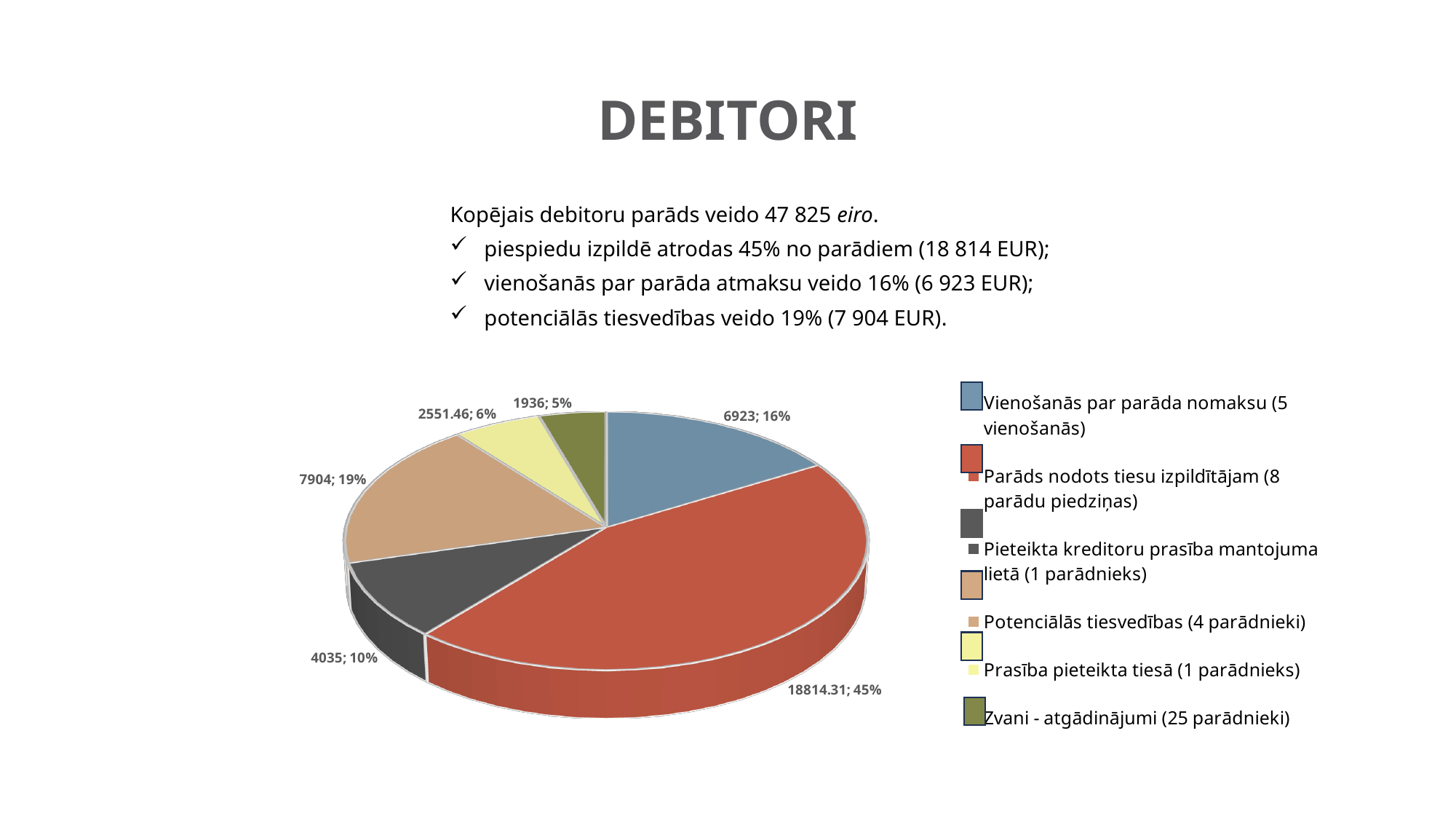
What value is shown for the slice 'Zvani - atgādinājumi (25 parādnieki)'? 1936 What is the difference between the values for 'Potenciālās tiesvedības (4 parādnieki)' and 'Pieteikta kreditoru prasība mantojuma lietā (1 parādnieks)'? 3869 What value is shown for the slice 'Potenciālās tiesvedības (4 parādnieki)'? 7904 What value is shown for the slice 'Vienošanās par parāda nomaksu (5 vienošanās)'? 6923 Which slice of the pie chart is the largest? Parāds nodots tiesu izpildītājam (8 parādu piedziņas) What type of chart is shown on the slide? pie chart What value is shown for the slice 'Parāds nodots tiesu izpildītājam (8 parādu piedziņas)'? 18814.31 Which is larger: the value for 'Potenciālās tiesvedības (4 parādnieki)' or for 'Vienošanās par parāda nomaksu (5 vienošanās)'? Potenciālās tiesvedības (4 parādnieki) Which slice of the pie chart is the smallest? Zvani - atgādinājumi (25 parādnieki) What percentage share does the slice 'Pieteikta kreditoru prasība mantojuma lietā (1 parādnieks)' have? 10% What percentage share does the slice 'Prasība pieteikta tiesā (1 parādnieks)' have? 6% How many slices does the pie chart have? 6